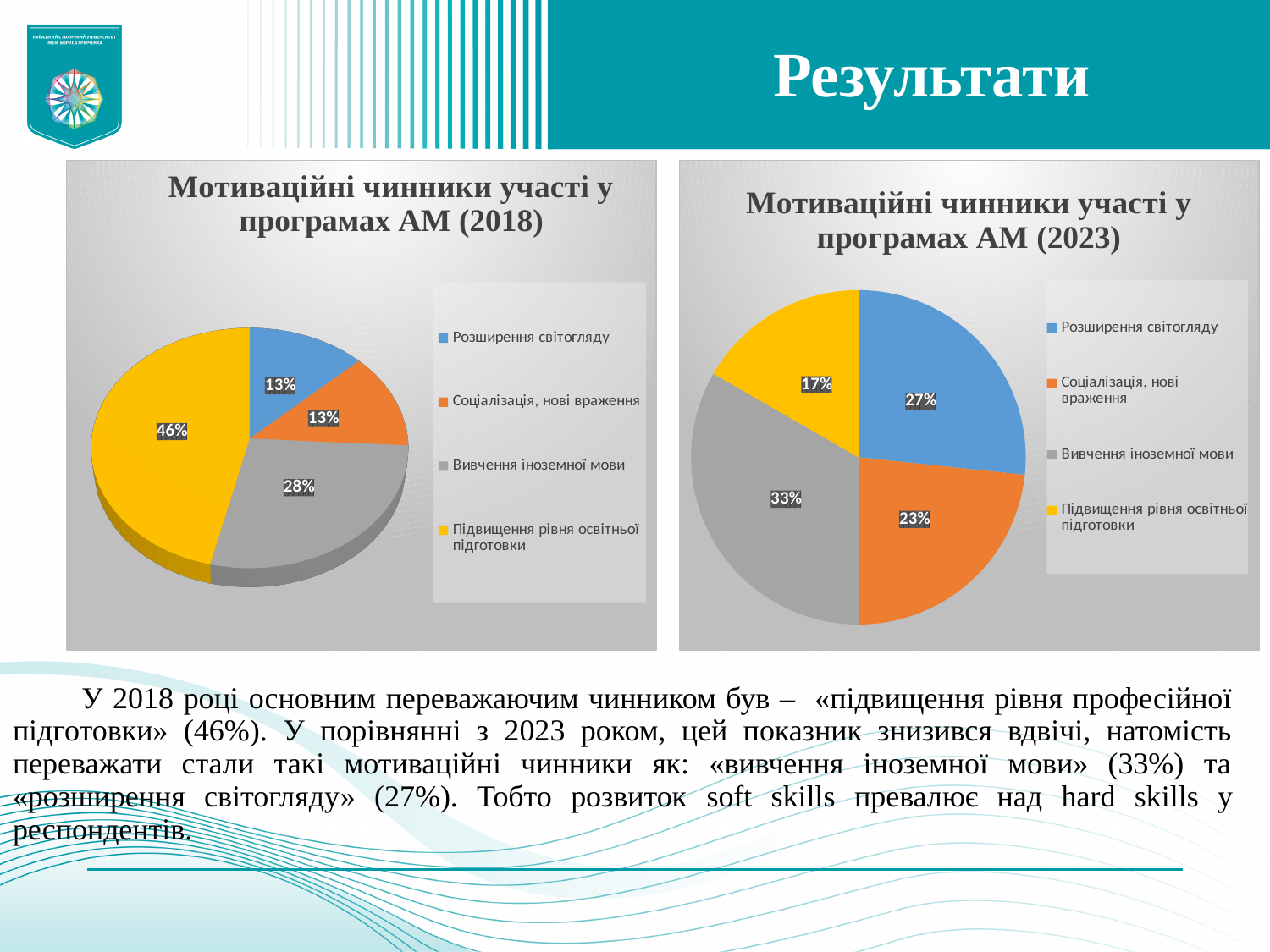
In the chart 'Мотиваційні чинники участі у програмах АМ (2023)', what share does 'Розширення світогляду' have? 27% In the chart 'Мотиваційні чинники участі у програмах АМ (2023)', what share does 'Вивчення іноземної мови' have? 33% In the chart 'Мотиваційні чинники участі у програмах АМ (2023)', which category has the largest share? Вивчення іноземної мови In the chart 'Мотиваційні чинники участі у програмах АМ (2018)', what is the difference between the shares of 'Підвищення рівня освітньої підготовки' and 'Вивчення іноземної мови'? 18% How many categories does the chart 'Мотиваційні чинники участі у програмах АМ (2018)' show? 4 In the chart 'Мотиваційні чинники участі у програмах АМ (2018)', which category has the largest share? Підвищення рівня освітньої підготовки In the chart 'Мотиваційні чинники участі у програмах АМ (2018)', what share does 'Підвищення рівня освітньої підготовки' have? 46% In the chart 'Мотиваційні чинники участі у програмах АМ (2023)', what is the difference between the shares of 'Розширення світогляду' and 'Соціалізація, нові враження'? 4% In the chart 'Мотиваційні чинники участі у програмах АМ (2018)', what colour is the slice for 'Вивчення іноземної мови'? Grey In the chart 'Мотиваційні чинники участі у програмах АМ (2023)', which category has the smallest share? Підвищення рівня освітньої підготовки Which is larger in the 2023 chart: the share of 'Соціалізація, нові враження' or the share of 'Підвищення рівня освітньої підготовки'? Соціалізація, нові враження What type of chart is 'Мотиваційні чинники участі у програмах АМ (2023)'? Pie chart